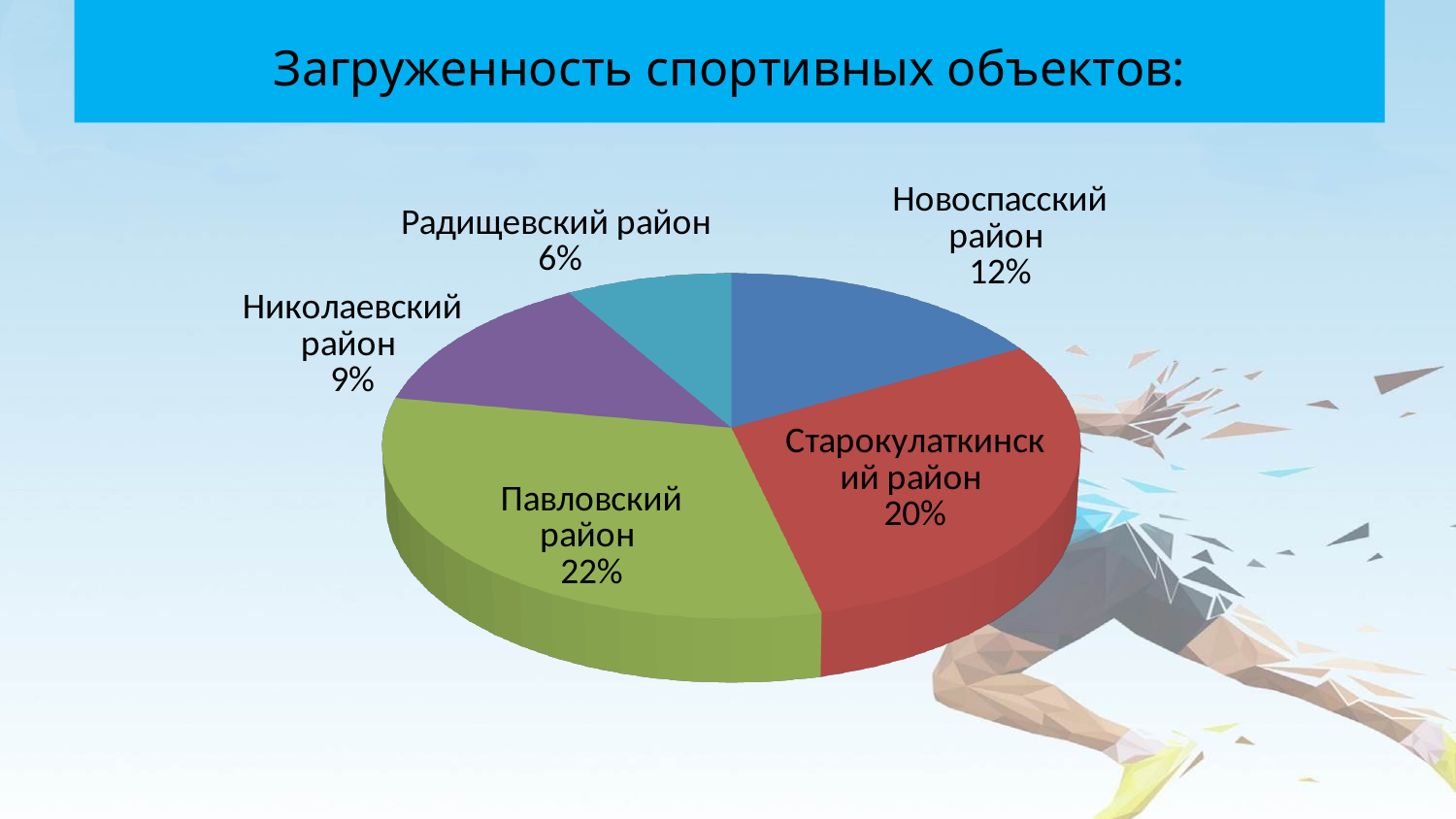
How many slices does the pie chart have? 5 What is the difference between the values for Павловский район and Новоспасский район? 10% What value is shown for Радищевский район? 6% What value is shown for Старокулаткинский район? 20% What kind of chart is shown on the slide? Pie chart What value is shown for Николаевский район? 9% What value is shown for Новоспасский район? 12% Which is larger, the value for Николаевский район or the value for Новоспасский район? Новоспасский район Which district has the smallest slice of the pie? Радищевский район Which district has the largest slice of the pie? Павловский район What value is shown for Павловский район? 22% What is the title of the chart? Загруженность спортивных объектов: